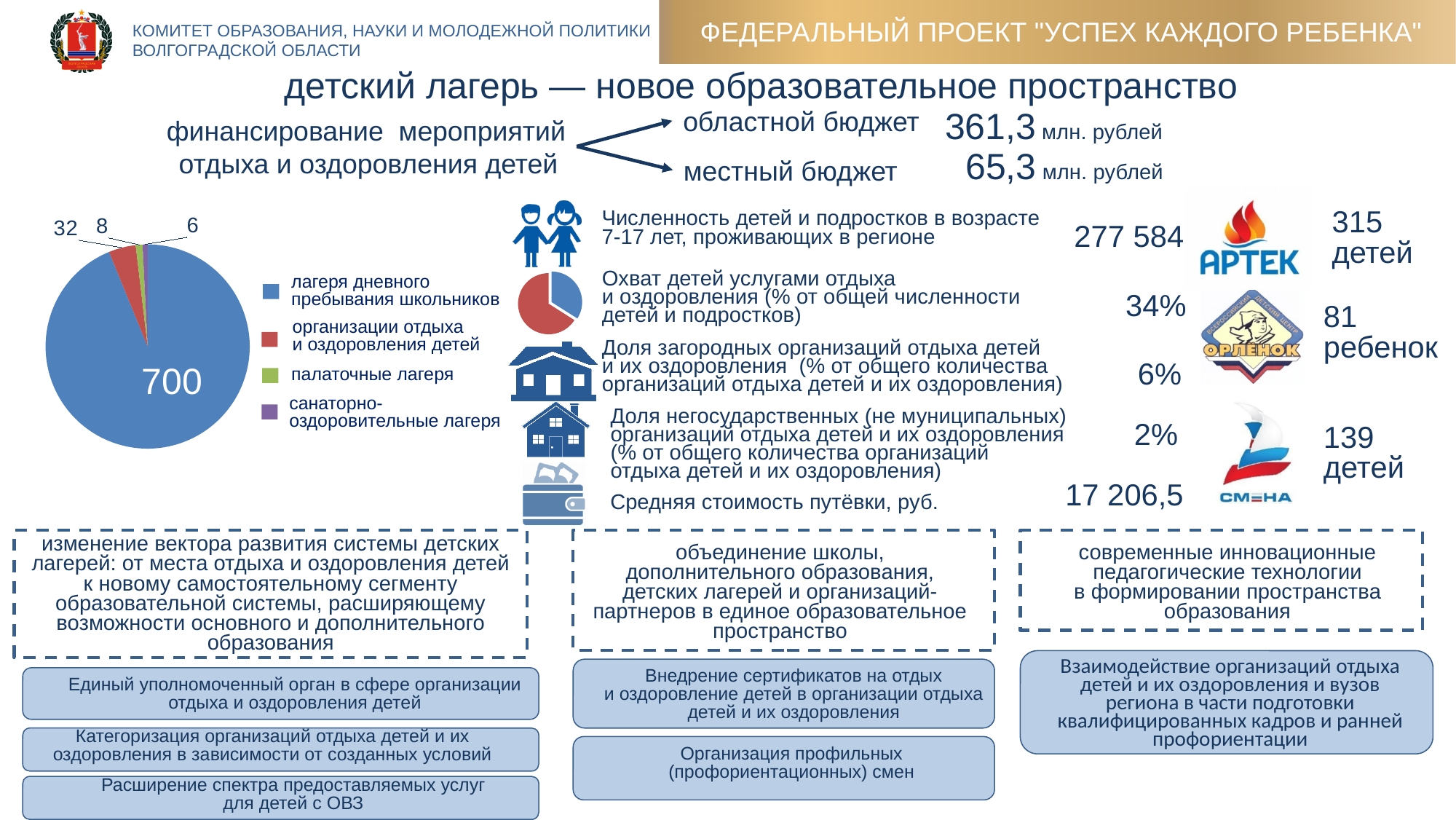
What colour is the slice for палаточные лагеря in the pie chart? green Which is larger in the pie chart: палаточные лагеря or санаторно-оздоровительные лагеря? палаточные лагеря Which category has the smallest slice in the pie chart? санаторно-оздоровительные лагеря What kind of chart is shown on the left of the slide? pie chart What is the value for лагеря дневного пребывания школьников in the pie chart? 700 What is the difference between the values for лагеря дневного пребывания школьников and организации отдыха и оздоровления детей in the pie chart? 668 What is the value for палаточные лагеря in the pie chart? 8 How many categories does the pie chart's legend list? 4 What is the total of all four values in the pie chart? 746 What is the value for организации отдыха и оздоровления детей in the pie chart? 32 Which category has the largest slice in the pie chart? лагеря дневного пребывания школьников What is the value for санаторно-оздоровительные лагеря in the pie chart? 6